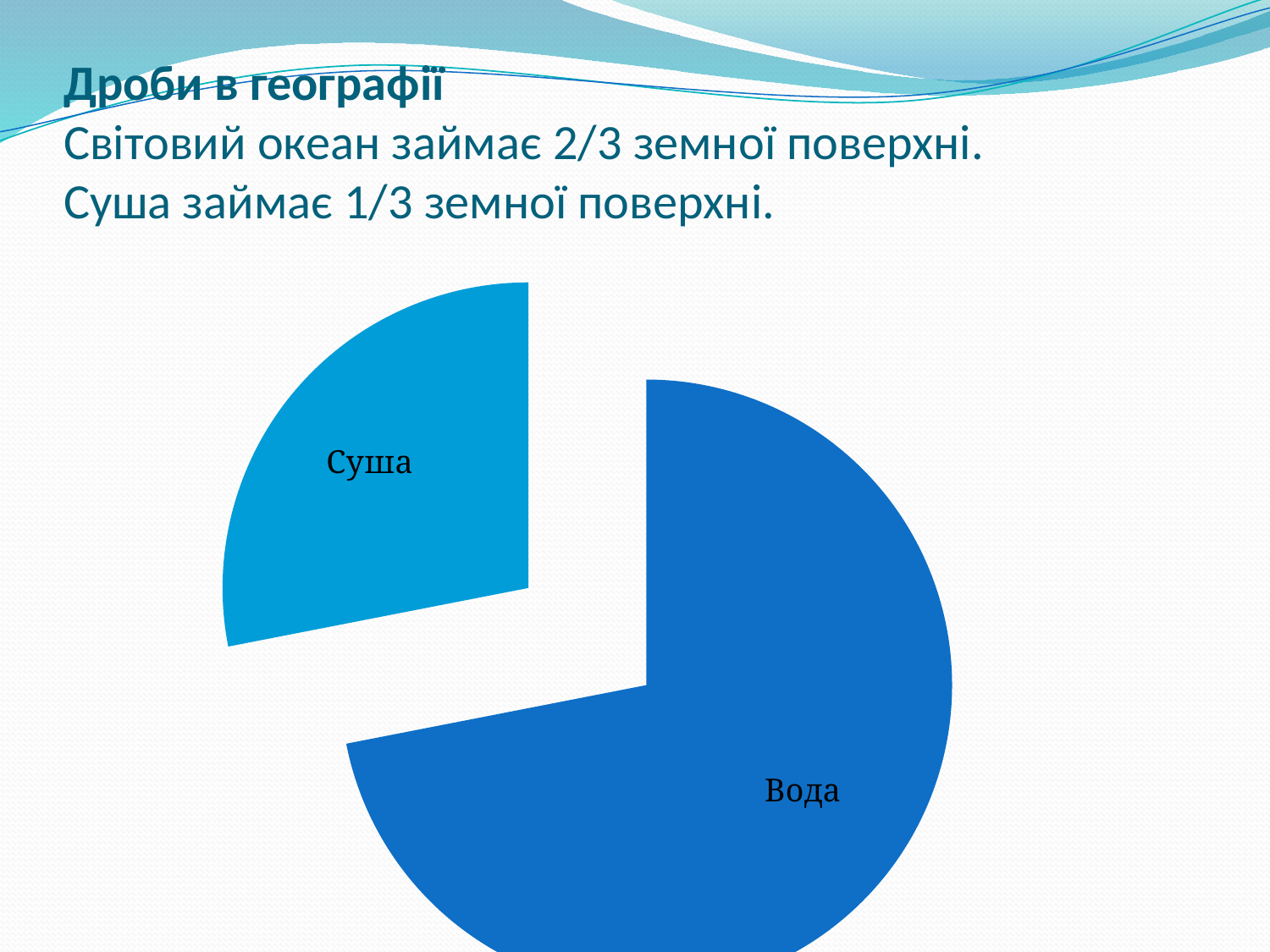
What are the labels of the two slices in the pie chart? Суша and Вода How many slices does the pie chart have? 2 According to the slide, what share of the Earth's surface does the Суша slice represent? 1/3 Which slice of the pie chart is the smallest? Суша What kind of chart is shown on the slide? pie chart Which slice of the pie chart is the largest? Вода Which slice is larger, Суша or Вода? Вода Which slice of the pie chart is drawn in the darker blue colour? Вода According to the slide, what share of the Earth's surface does the Вода (ocean) slice represent? 2/3